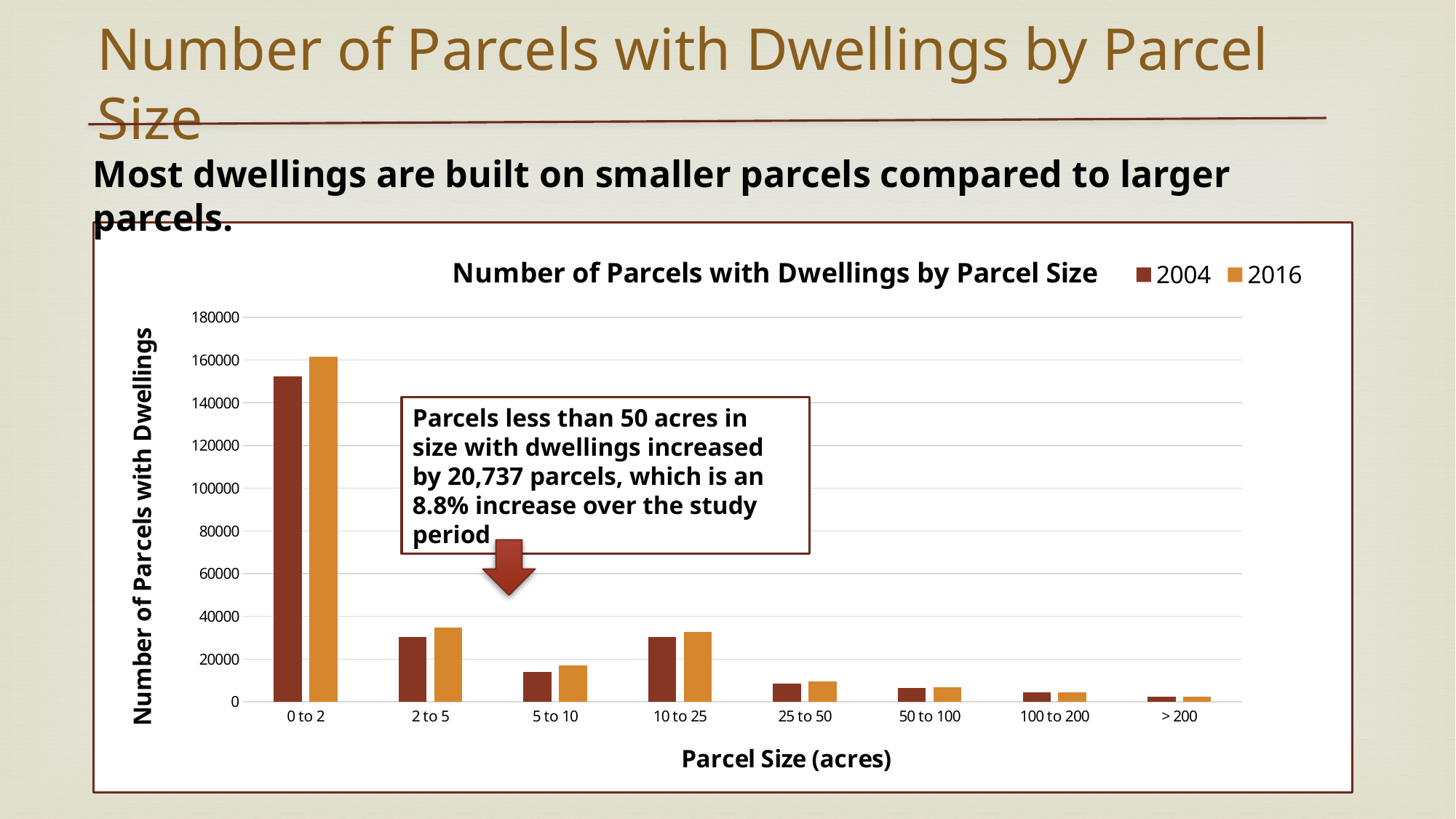
For the 0 to 2 acre category, which year has the larger value, 2004 or 2016? 2016 Which parcel size category has the highest number of parcels with dwellings in 2016? 0 to 2 Do the values generally rise or fall as parcel size increases along the x axis? fall Is the 2004 value for the 0 to 2 category greater or less than 140000? greater Is the 2016 value for the 10 to 25 category greater or less than 20000? greater What kind of chart is shown on the slide? Bar chart In 2004, which category has the larger value, 2 to 5 or 5 to 10? 2 to 5 What is the title of the x axis? Parcel Size (acres) How many series does the chart legend list? 2 Is the 2016 value for the 2 to 5 category greater or less than 40000? less How many parcel size categories are shown on the x axis? 8 Which parcel size category has the lowest number of parcels with dwellings in 2004? > 200